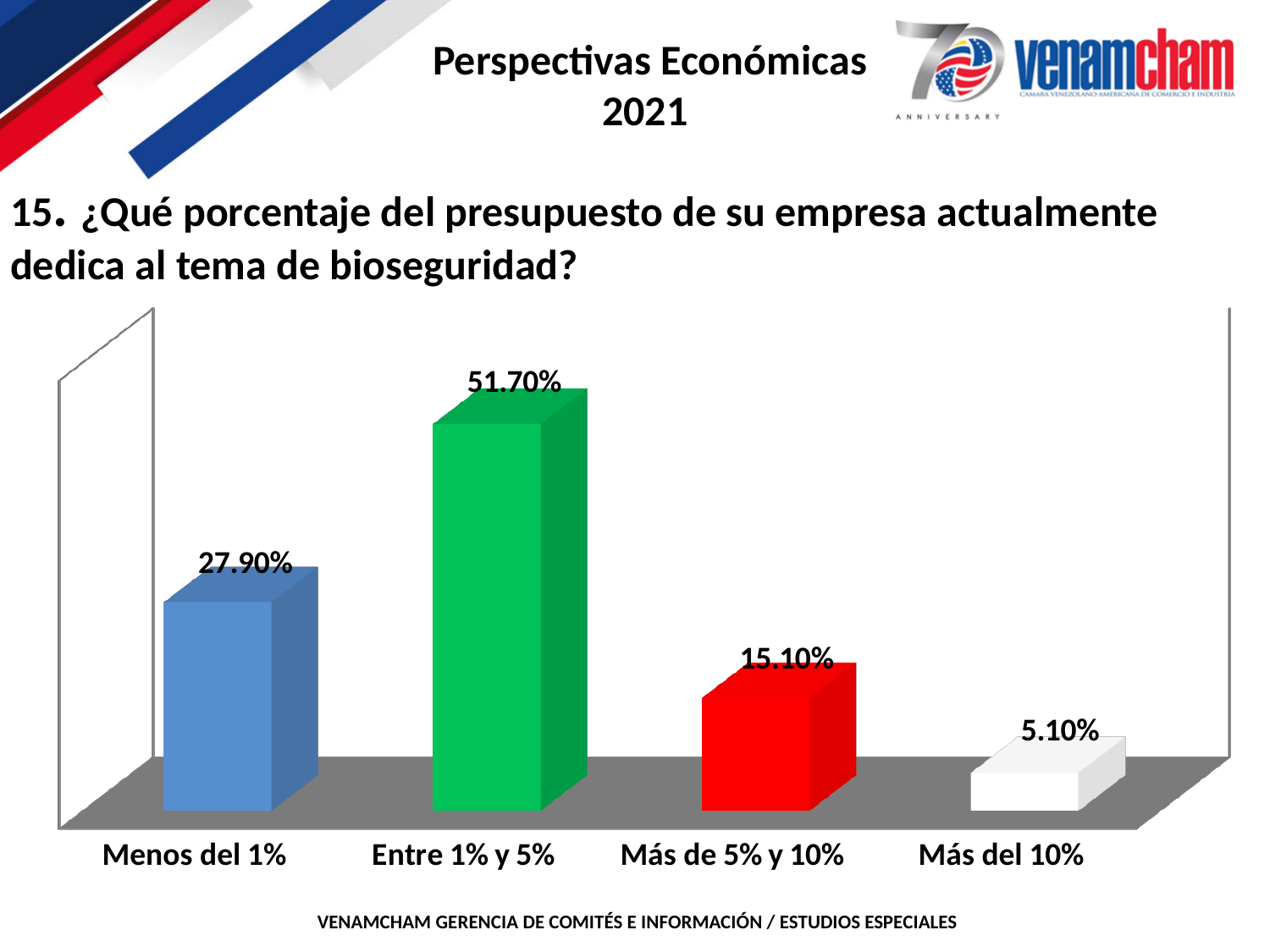
What is the difference between the values for 'Más de 5% y 10%' and 'Más del 10%'? 10.00% What colour is the bar for 'Entre 1% y 5%'? Green What is the value shown for 'Más del 10%'? 5.10% Which category has the lowest value? Más del 10% What percentage of respondents dedicate less than 1% of their budget to biosecurity (Menos del 1%)? 27.90% What is the value shown for the category 'Entre 1% y 5%'? 51.70% How many categories are shown in the chart? 4 Which category has the highest value? Entre 1% y 5% What is the value shown for 'Más de 5% y 10%'? 15.10% What is the difference between the values for 'Entre 1% y 5%' and 'Menos del 1%'? 23.80% What kind of chart is shown on the slide? Bar chart Which is larger, the value for 'Menos del 1%' or the value for 'Más de 5% y 10%'? Menos del 1%